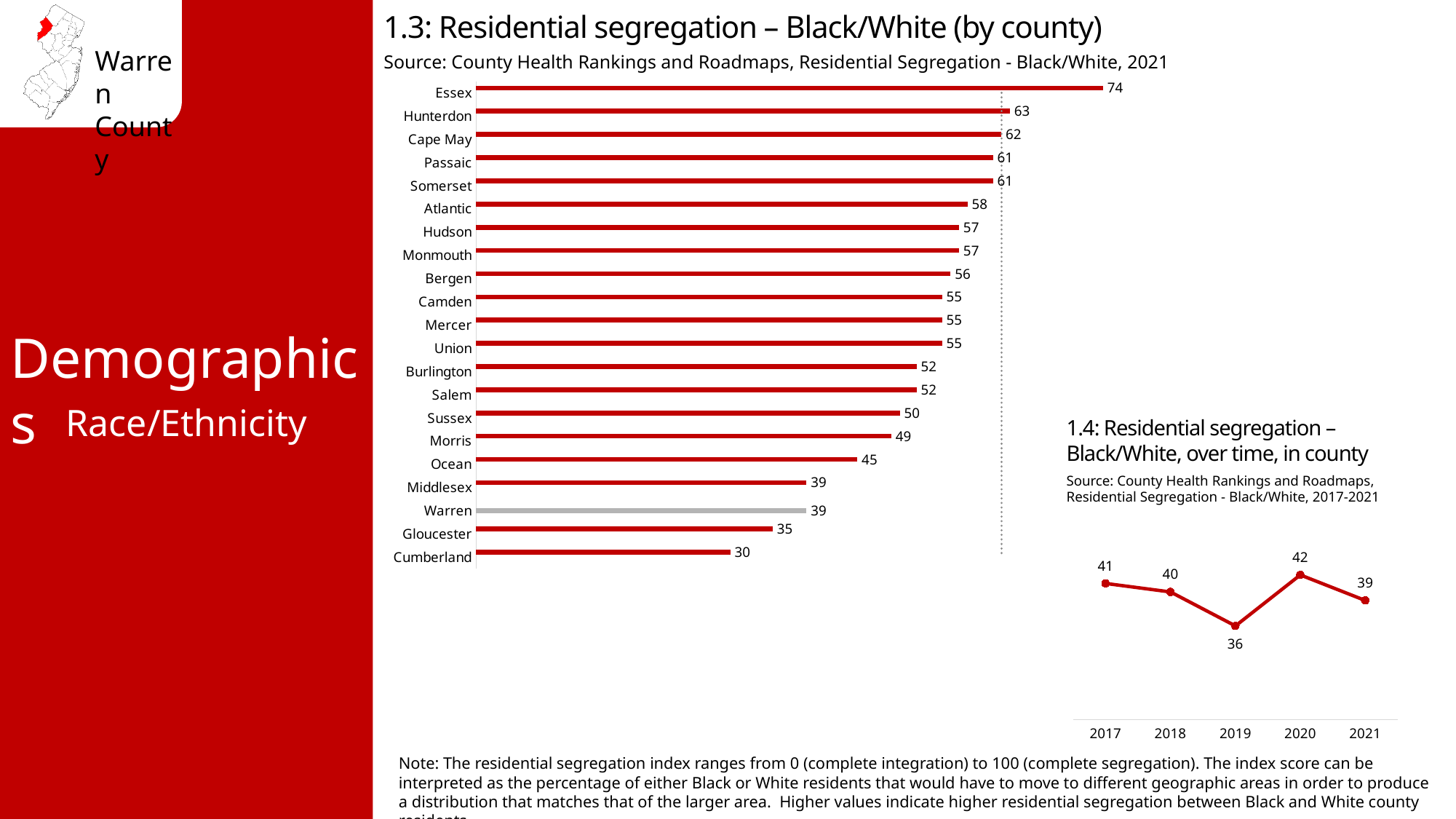
In the chart '1.3: Residential segregation – Black/White (by county)', what is the difference between the values for Essex and Cumberland? 44 In the chart '1.3: Residential segregation – Black/White (by county)', which has a higher value, Ocean or Morris? Ocean In the chart '1.3: Residential segregation – Black/White (by county)', which county has the highest value? Essex In the chart '1.4: Residential segregation – Black/White, over time, in county', what is the difference between the values for 2020 and 2019? 6 In the chart '1.3: Residential segregation – Black/White (by county)', what is the value for Essex? 74 What kind of chart is '1.4: Residential segregation – Black/White, over time, in county'? Line chart In the chart '1.4: Residential segregation – Black/White, over time, in county', what is the value for 2019? 36 What kind of chart is '1.3: Residential segregation – Black/White (by county)'? Bar chart How many counties are shown in the chart '1.3: Residential segregation – Black/White (by county)'? 21 In the chart '1.3: Residential segregation – Black/White (by county)', what is the value for Warren? 39 In the chart '1.4: Residential segregation – Black/White, over time, in county', which year has the highest value? 2020 In the chart '1.3: Residential segregation – Black/White (by county)', which county has the lowest value? Cumberland